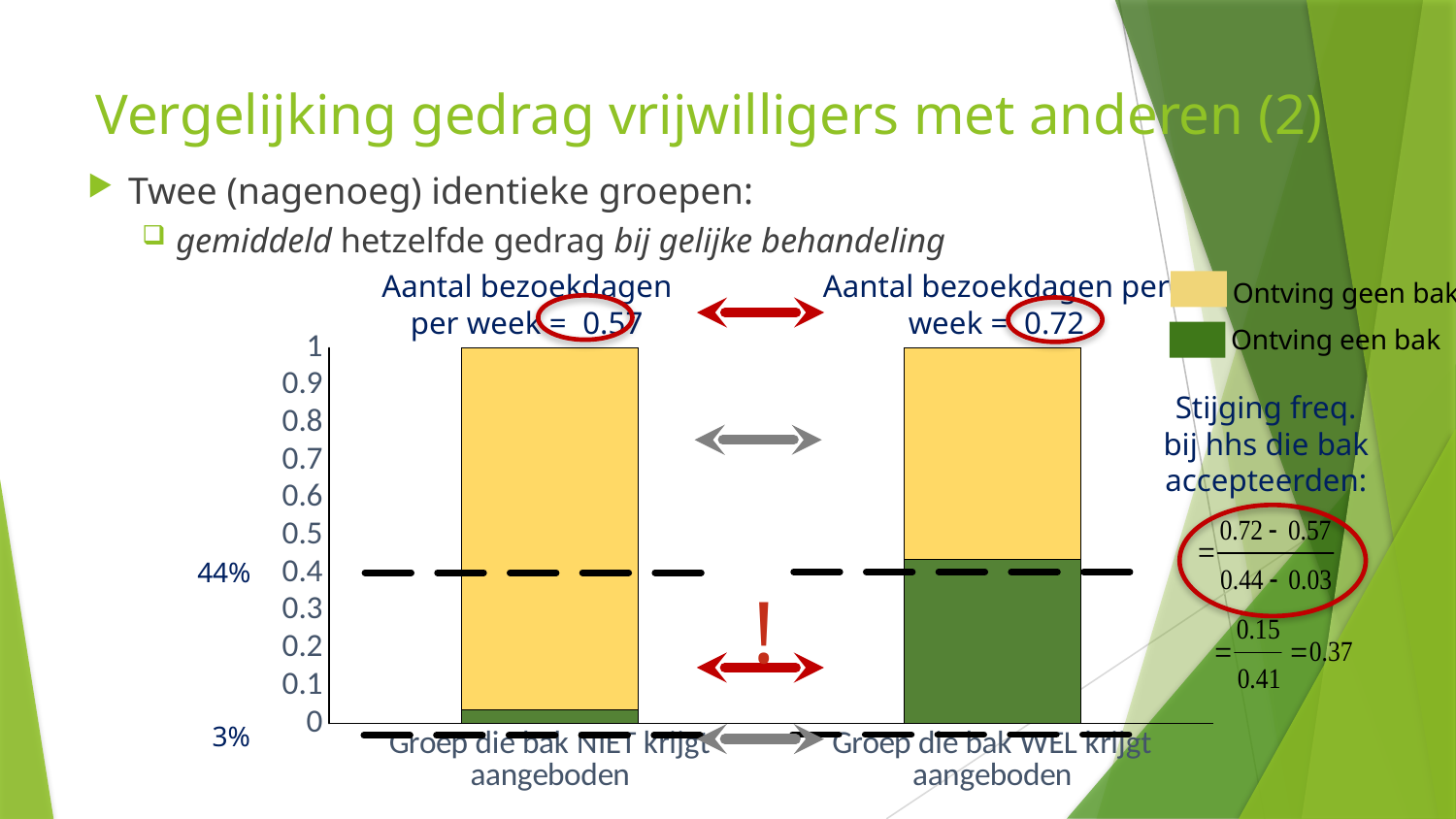
Which group has the larger 'Ontving een bak' segment? Groep die bak WEL krijgt aangeboden What kind of chart is shown on the slide? stacked bar chart Which group has the larger 'Ontving geen bak' segment? Groep die bak NIET krijgt aangeboden Which series is shown in green in the chart? Ontving een bak What is the total height of the stacked bar for 'Groep die bak NIET krijgt aangeboden'? 1 Which series is shown in yellow in the chart? Ontving geen bak How many series does the chart legend list? 2 How many categories are shown on the x axis of the chart? 2 Is the 'Ontving een bak' value for 'Groep die bak WEL krijgt aangeboden' greater or less than 0.3? greater Is the 'Ontving een bak' value for 'Groep die bak NIET krijgt aangeboden' greater or less than 0.1? less What is the total height of the stacked bar for 'Groep die bak WEL krijgt aangeboden'? 1 Is the 'Ontving geen bak' value for 'Groep die bak NIET krijgt aangeboden' greater or less than 0.9? greater